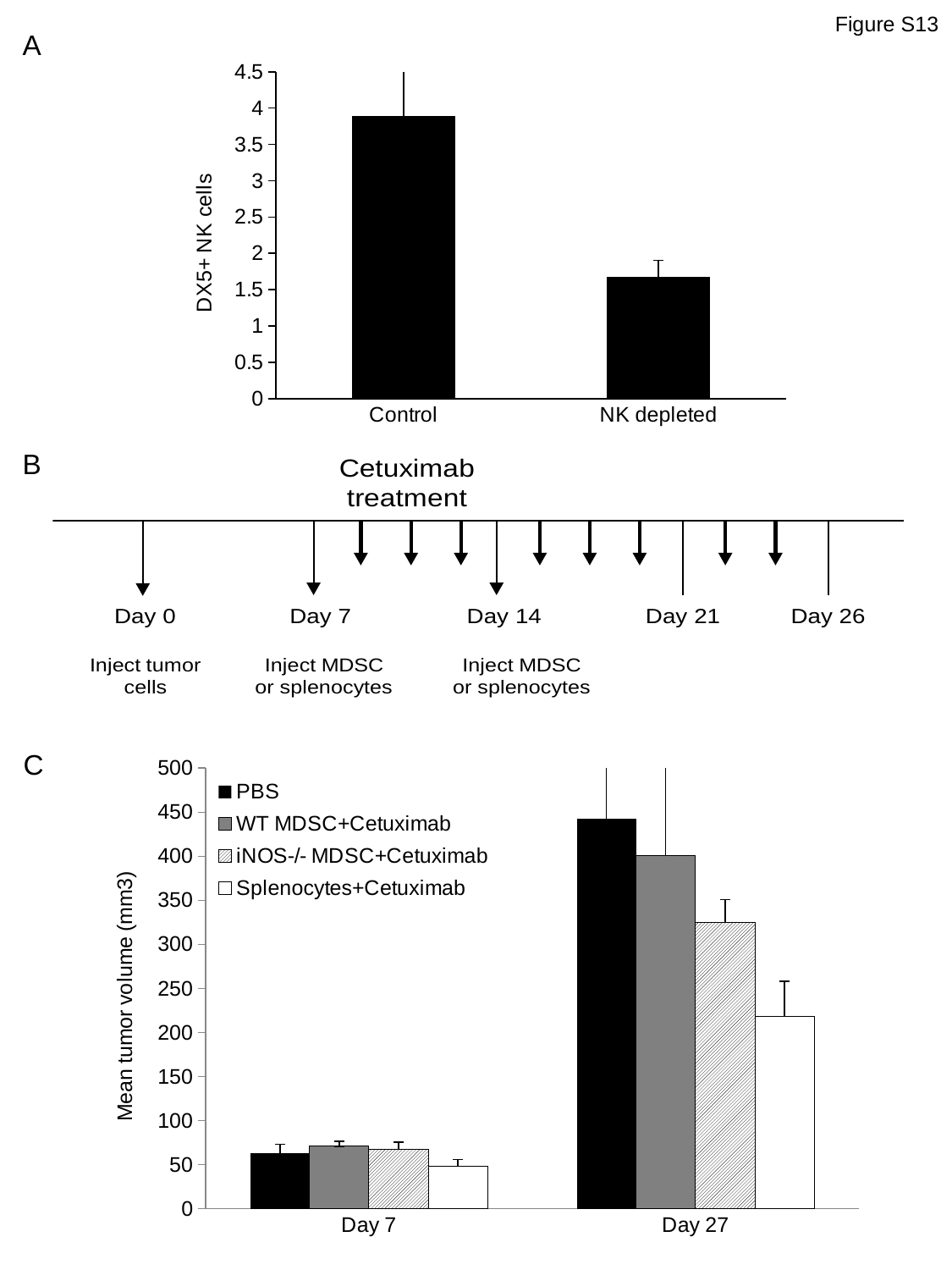
In panel C, is the PBS value at Day 27 greater or less than 400? greater In panel A, how many categories are plotted on the x axis? 2 In panel A, what kind of chart is shown? bar chart In panel A, which category has the higher value of DX5+ NK cells? Control In panel C, at Day 27, which is larger: iNOS-/- MDSC+Cetuximab or Splenocytes+Cetuximab? iNOS-/- MDSC+Cetuximab In panel C, what is the label of the y axis? Mean tumor volume (mm3) In panel C, how many time points are plotted on the x axis? 2 In panel C, how many series does the legend list? 4 In panel C, which series has the highest mean tumor volume at Day 27? PBS In panel A, is the value for Control greater or less than 3.5? greater In panel C, which series has the lowest mean tumor volume at Day 27? Splenocytes+Cetuximab In panel A, is the value for NK depleted greater or less than 2? less